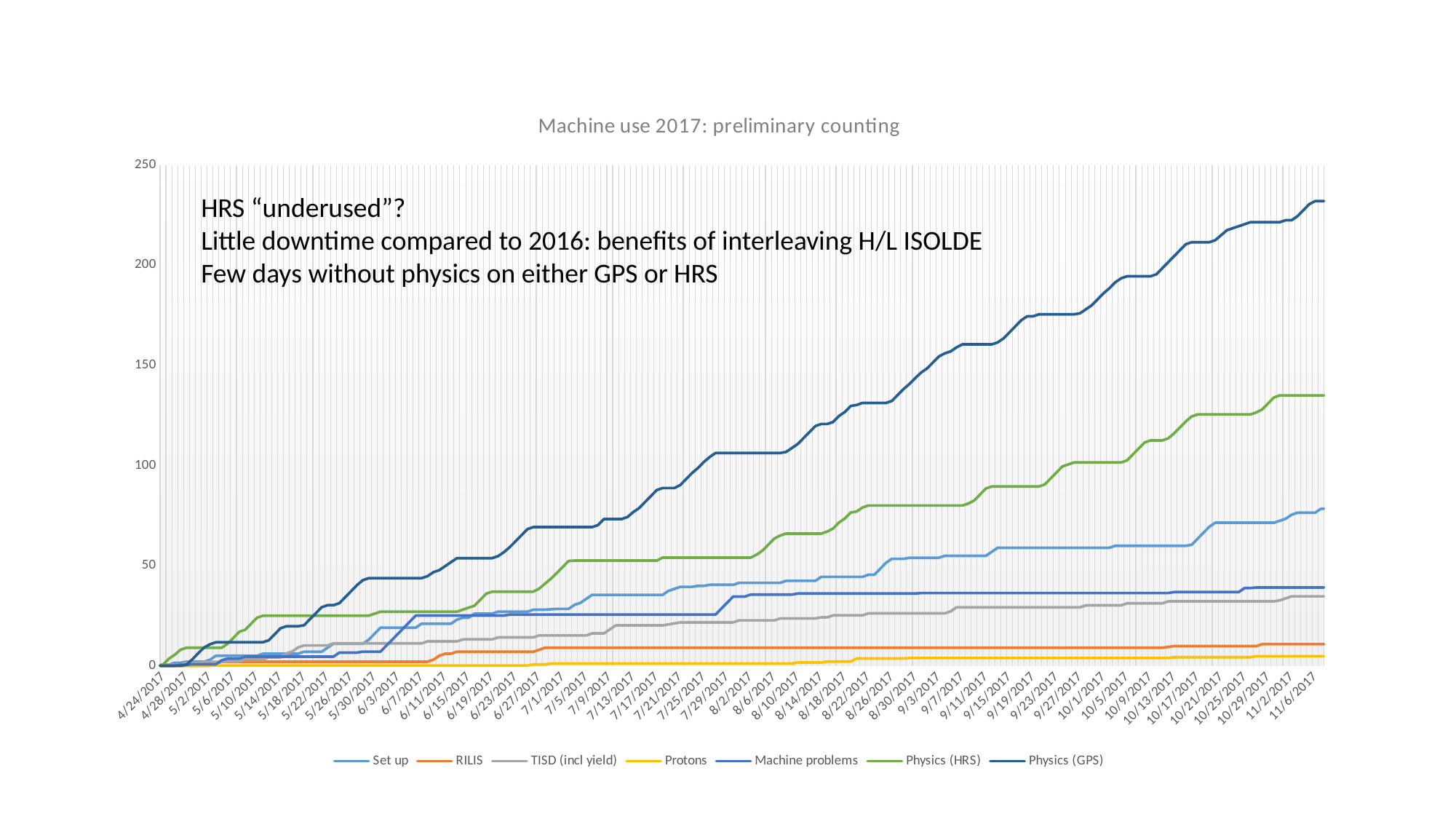
What is the title of the chart? Machine use 2017: preliminary counting Is the value for Machine problems at 11/6/2017 greater or less than 50? less At 11/6/2017, which is larger: Physics (GPS) or Physics (HRS)? Physics (GPS) Does the Physics (GPS) series rise or fall along the x axis? rise Which series has the lowest value at the end of the x axis (11/6/2017)? Protons Is the value for Physics (HRS) at 11/6/2017 greater or less than 100? greater Which series reaches the highest value at the end of the x axis (11/6/2017)? Physics (GPS) How many series does the legend list? 7 Is the value for Physics (GPS) at 11/6/2017 greater or less than 200? greater What kind of chart is shown on the slide? line chart At 11/6/2017, which is larger: Set up or TISD (incl yield)? Set up